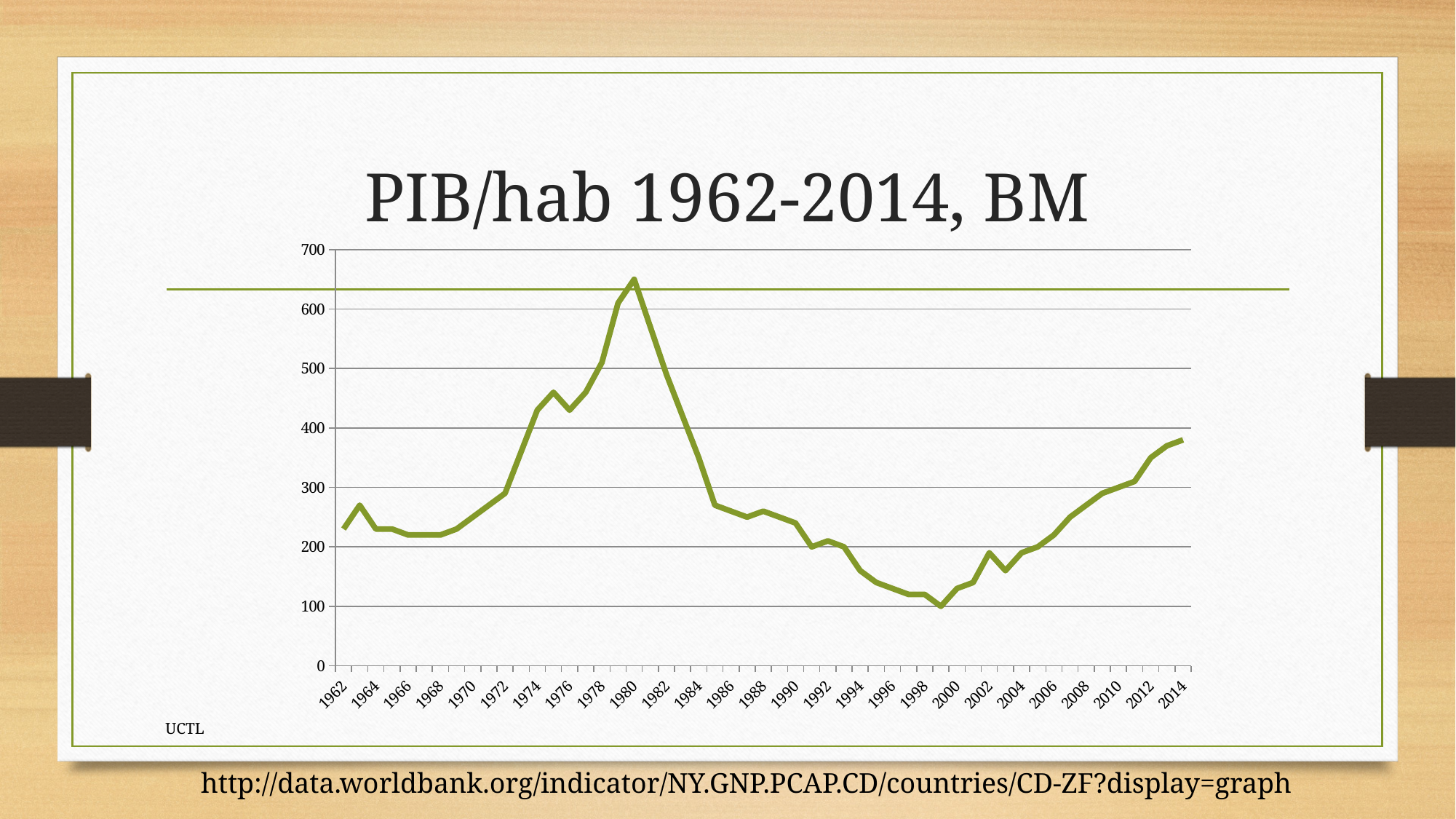
Which year has the larger value, 1962 or 2014? 2014 Is the value for 1962 greater or less than 200? greater Is the value for 2014 greater or less than 400? less What kind of chart is shown on the slide? line chart Which year has the larger value, 1980 or 2014? 1980 Is the value for 1974 greater or less than 400? greater In which year does the line reach its highest value? 1980 Does the line rise or fall between 2004 and 2014? rise What is the title of the chart? PIB/hab 1962-2014, BM Does the line rise or fall between 1980 and 1998? fall